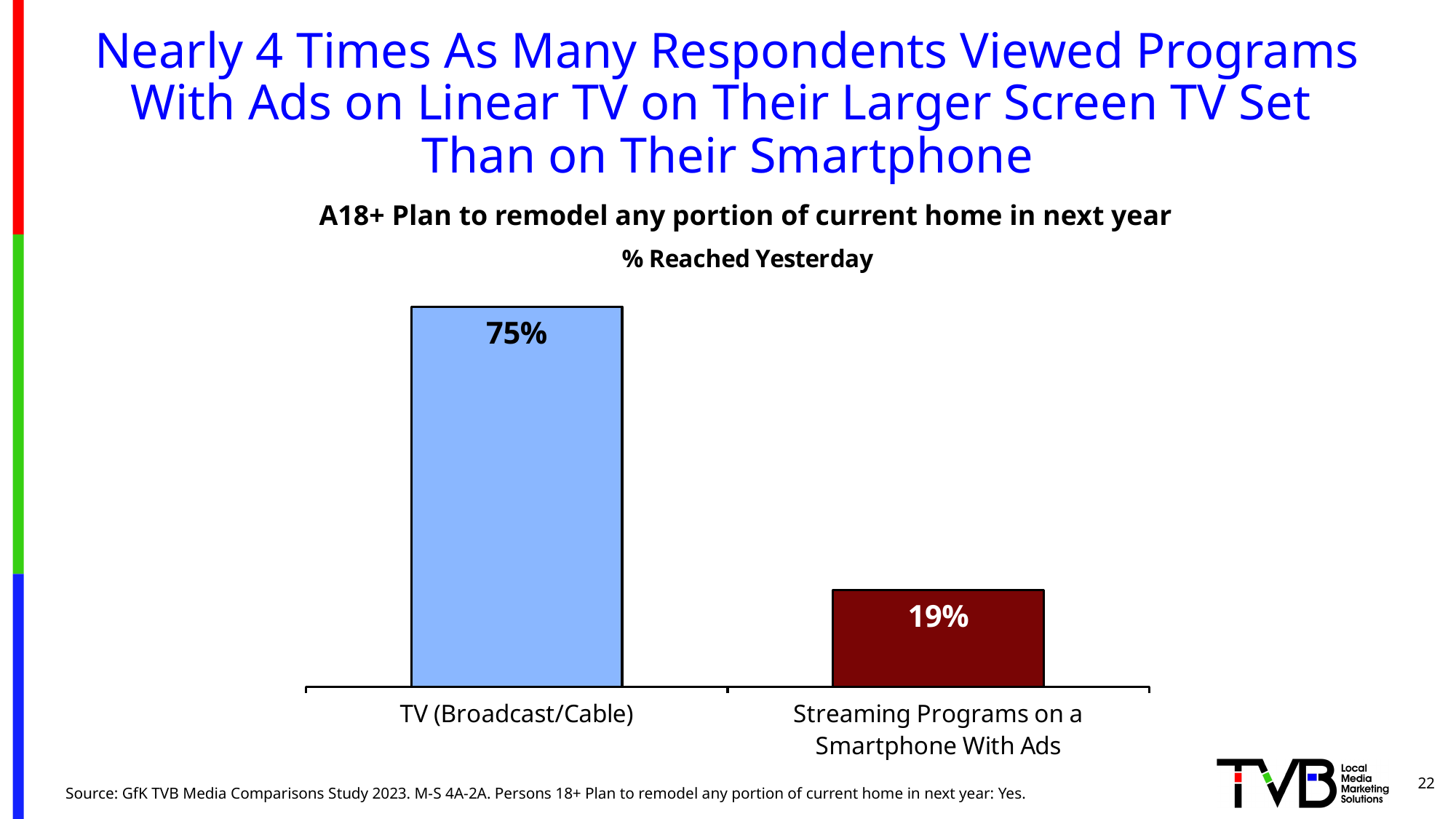
Which category has the highest % Reached Yesterday? TV (Broadcast/Cable) How many categories are shown in the chart? 2 Which category has the lowest % Reached Yesterday? Streaming Programs on a Smartphone With Ads What is the % Reached Yesterday value for Streaming Programs on a Smartphone With Ads? 19% What is the difference in percentage points between TV (Broadcast/Cable) and Streaming Programs on a Smartphone With Ads? 56 percentage points What is the chart's title? % Reached Yesterday What kind of chart is shown on the slide? Bar chart What is the % Reached Yesterday value for TV (Broadcast/Cable)? 75% What colour is the bar for Streaming Programs on a Smartphone With Ads? Dark red What metric does the chart's subtitle say is plotted? % Reached Yesterday Which is larger: the value for TV (Broadcast/Cable) or the value for Streaming Programs on a Smartphone With Ads? TV (Broadcast/Cable)